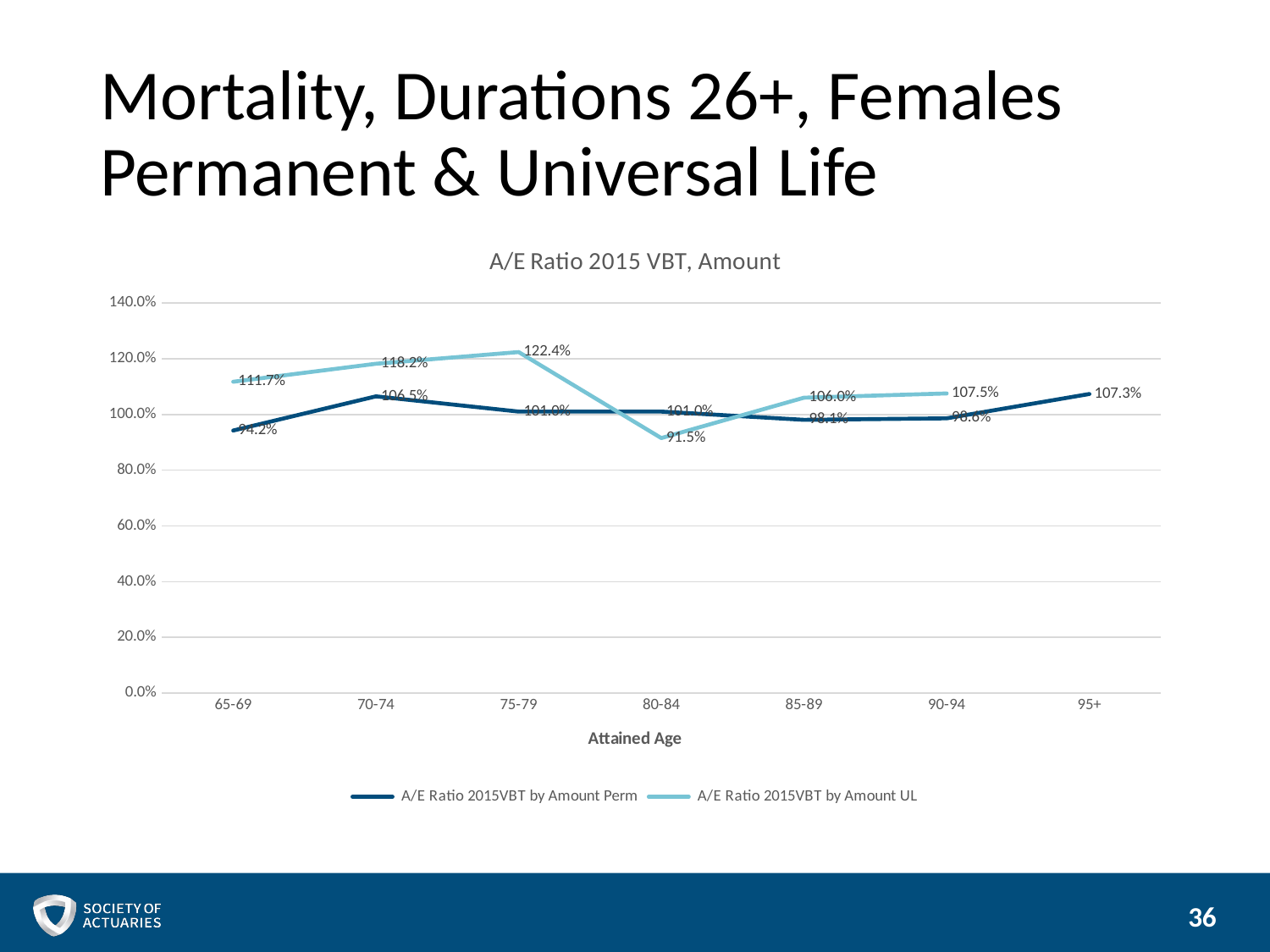
At which attained age group is the A/E Ratio 2015VBT by Amount UL series lowest? 80-84 What is the A/E Ratio 2015VBT by Amount Perm value for attained age 65-69? 94.2% What is the difference between the UL values at 75-79 and 80-84? 30.9 percentage points At which attained age group is the A/E Ratio 2015VBT by Amount UL series highest? 75-79 What is the A/E Ratio 2015VBT by Amount Perm value for attained age 95+? 107.3% How many series does the legend list? 2 What is the A/E Ratio 2015VBT by Amount UL value for attained age 75-79? 122.4% Is the A/E Ratio 2015VBT by Amount UL value for attained age 65-69 greater or less than 100.0%? greater At which attained age group is the A/E Ratio 2015VBT by Amount Perm series lowest? 65-69 What is the A/E Ratio 2015VBT by Amount UL value for attained age 80-84? 91.5% At attained age 70-74, which series has the higher value, Perm or UL? UL How many attained age groups are shown on the x axis? 7